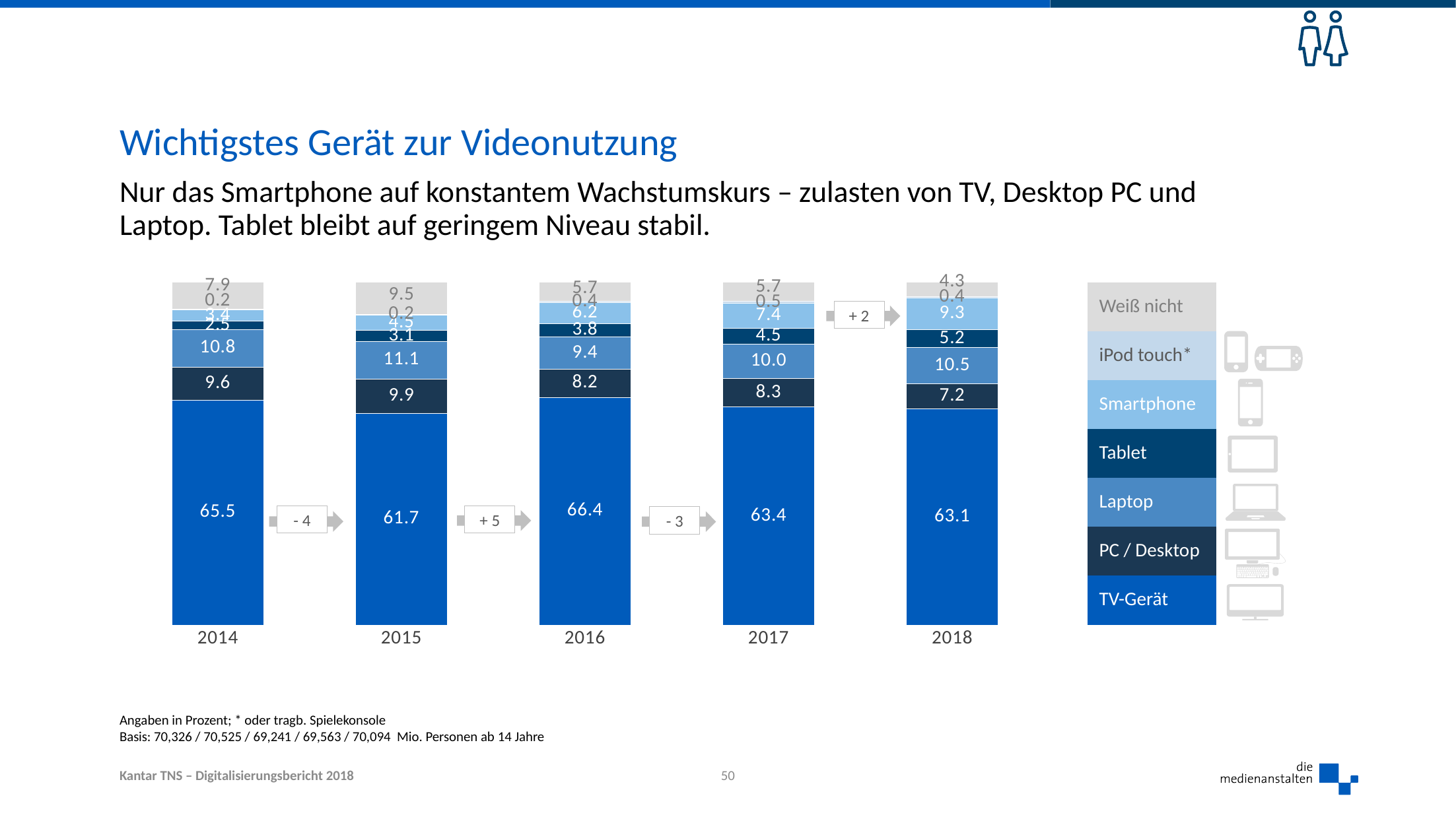
What is the difference between the TV-Gerät values for 2014 and 2015? 3.8 How many series does the legend list? 7 Does the Smartphone value rise or fall from 2014 to 2018? rise How many years are shown on the x axis? 5 In which year is the Smartphone value lowest? 2014 What is the value for Tablet in 2017? 4.5 Which is larger, the Laptop value in 2018 or the PC / Desktop value in 2018? Laptop What is the value for Smartphone in 2018? 9.3 What is the value for PC / Desktop in 2018? 7.2 What is the value for Laptop in 2015? 11.1 In which year is the TV-Gerät value highest? 2016 What is the value for TV-Gerät in 2016? 66.4